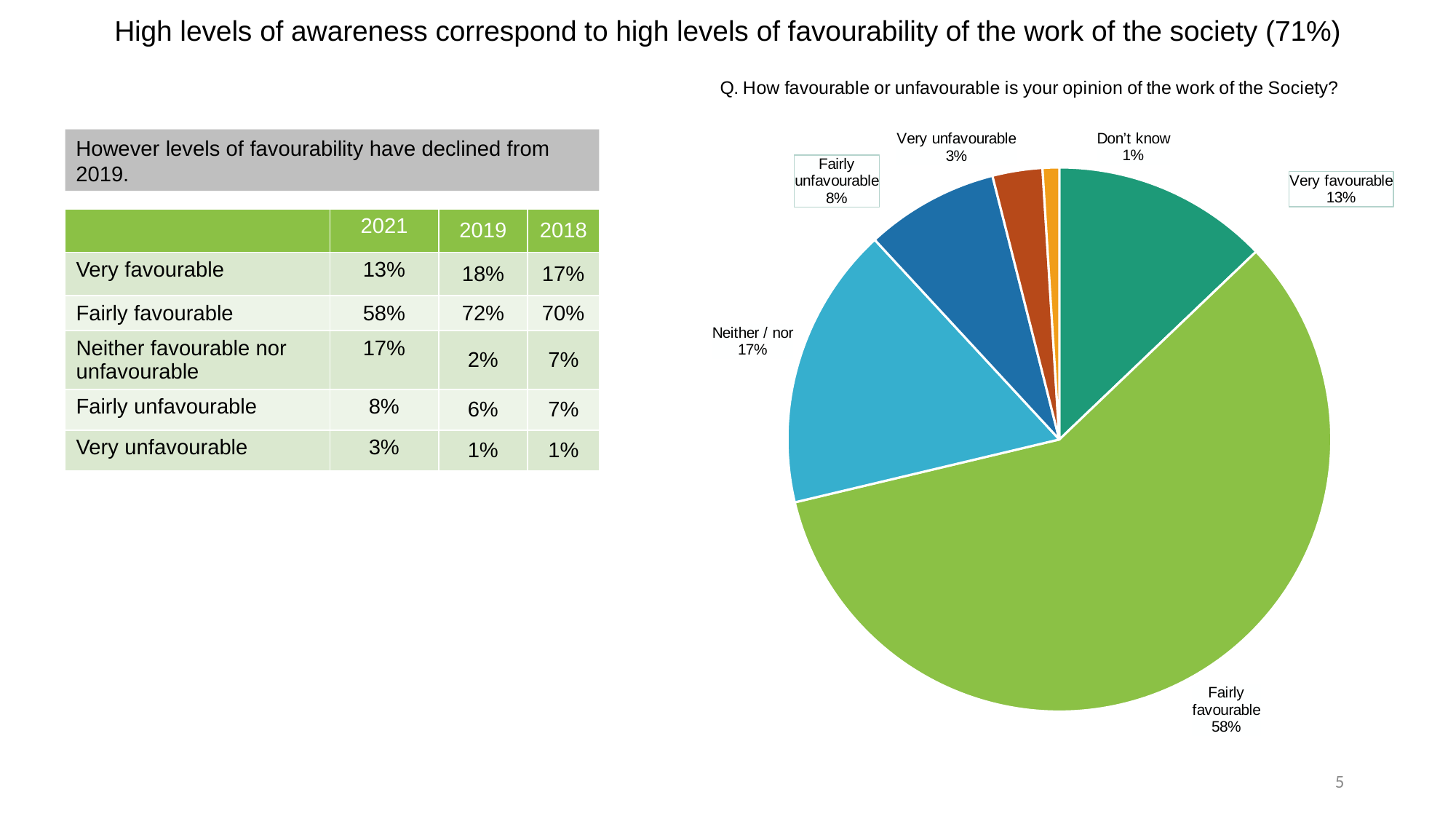
What share of the pie is Neither / nor? 17% Which slice of the pie is the smallest? Don't know What share of the pie is Fairly unfavourable? 8% What share of the pie is Don't know? 1% What share of the pie is Very unfavourable? 3% What share of the pie is Fairly favourable? 58% Which is larger, the Neither / nor slice or the Fairly unfavourable slice? Neither / nor What is the difference between the Fairly favourable and Very favourable slices? 45% How many slices does the pie chart have? 6 Which slice of the pie is the largest? Fairly favourable What share of the pie is Very favourable? 13% What kind of chart is shown on the slide? Pie chart